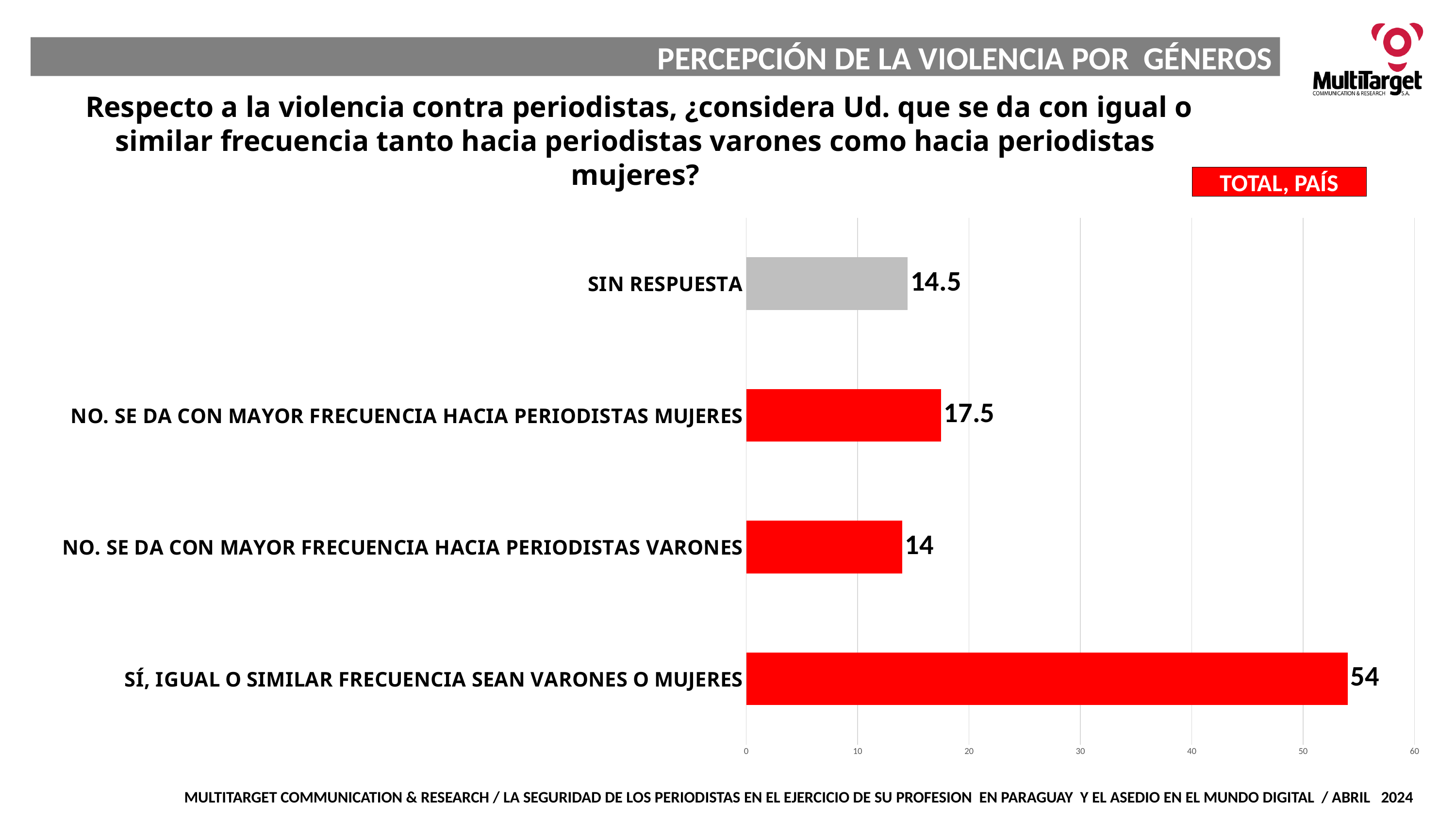
What is the value for "NO. SE DA CON MAYOR FRECUENCIA HACIA PERIODISTAS MUJERES"? 17.5 What is the value for "SIN RESPUESTA"? 14.5 What is the difference between the value for "NO. SE DA CON MAYOR FRECUENCIA HACIA PERIODISTAS MUJERES" and the value for "NO. SE DA CON MAYOR FRECUENCIA HACIA PERIODISTAS VARONES"? 3.5 Is the value for "SÍ, IGUAL O SIMILAR FRECUENCIA SEAN VARONES O MUJERES" greater or less than 50? greater What is the difference between the value for "SÍ, IGUAL O SIMILAR FRECUENCIA SEAN VARONES O MUJERES" and the value for "NO. SE DA CON MAYOR FRECUENCIA HACIA PERIODISTAS MUJERES"? 36.5 What is the value for "SÍ, IGUAL O SIMILAR FRECUENCIA SEAN VARONES O MUJERES"? 54 What is the value for "NO. SE DA CON MAYOR FRECUENCIA HACIA PERIODISTAS VARONES"? 14 What kind of chart is shown on the slide? bar chart Which category has the lowest value? NO. SE DA CON MAYOR FRECUENCIA HACIA PERIODISTAS VARONES Which is larger: the value for "NO. SE DA CON MAYOR FRECUENCIA HACIA PERIODISTAS MUJERES" or the value for "SIN RESPUESTA"? NO. SE DA CON MAYOR FRECUENCIA HACIA PERIODISTAS MUJERES How many categories are shown in the chart? 4 Which category has the highest value? SÍ, IGUAL O SIMILAR FRECUENCIA SEAN VARONES O MUJERES